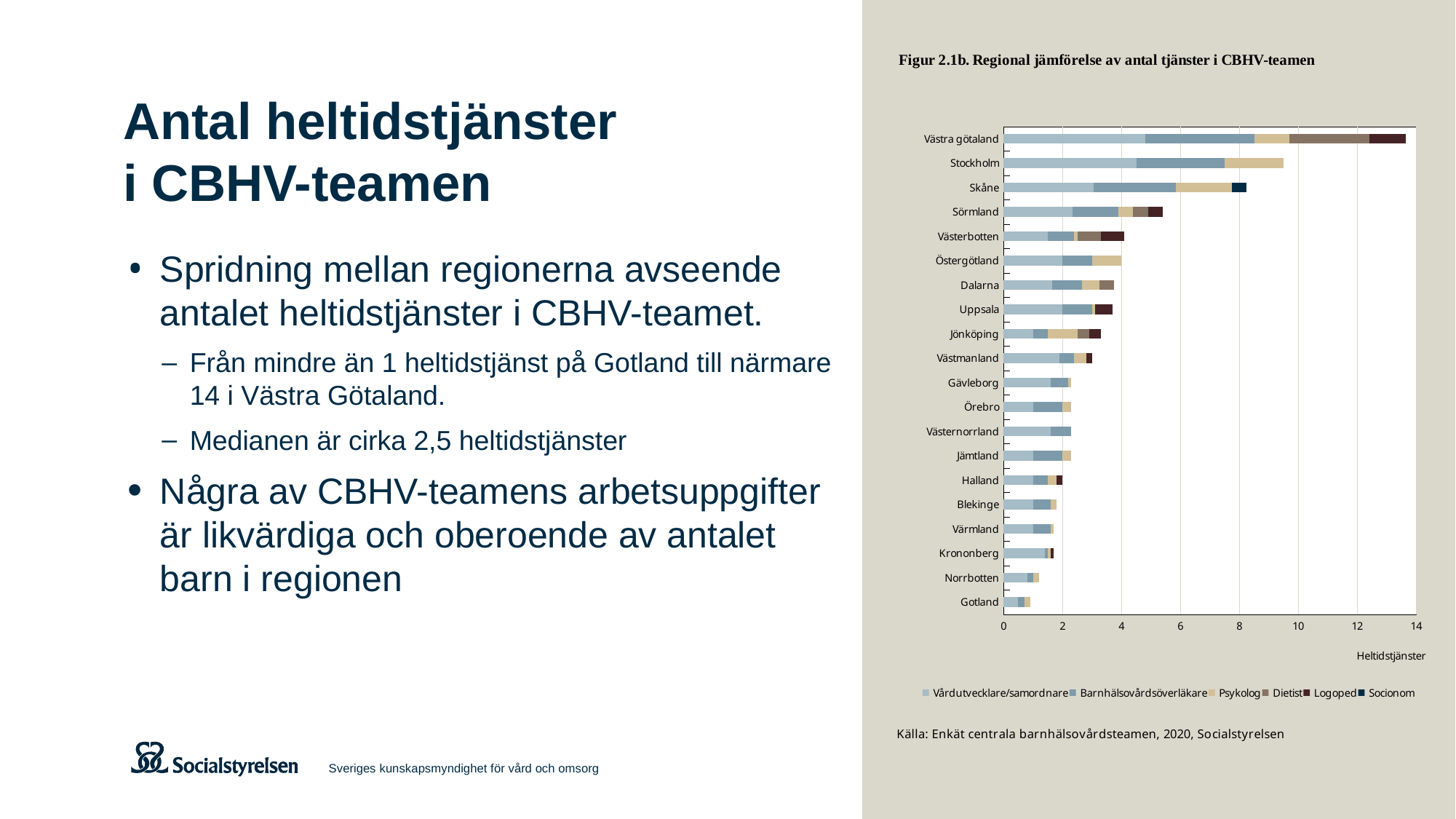
Is the total value for Västra götaland greater or less than 12? greater Which region has the longest bar (most full-time positions)? Västra götaland What kind of chart is shown on the slide? Stacked bar chart What is the title of the chart? Figur 2.1b. Regional jämförelse av antal tjänster i CBHV-teamen How many series does the chart legend list? 6 Is the total value for Sörmland greater or less than 4? greater Is the total value for Gotland greater or less than 2? less Which region has the shortest bar (fewest full-time positions)? Gotland How many regions are listed on the chart? 20 What is the label on the x axis of the chart? Heltidstjänster Which region has a longer bar, Stockholm or Skåne? Stockholm